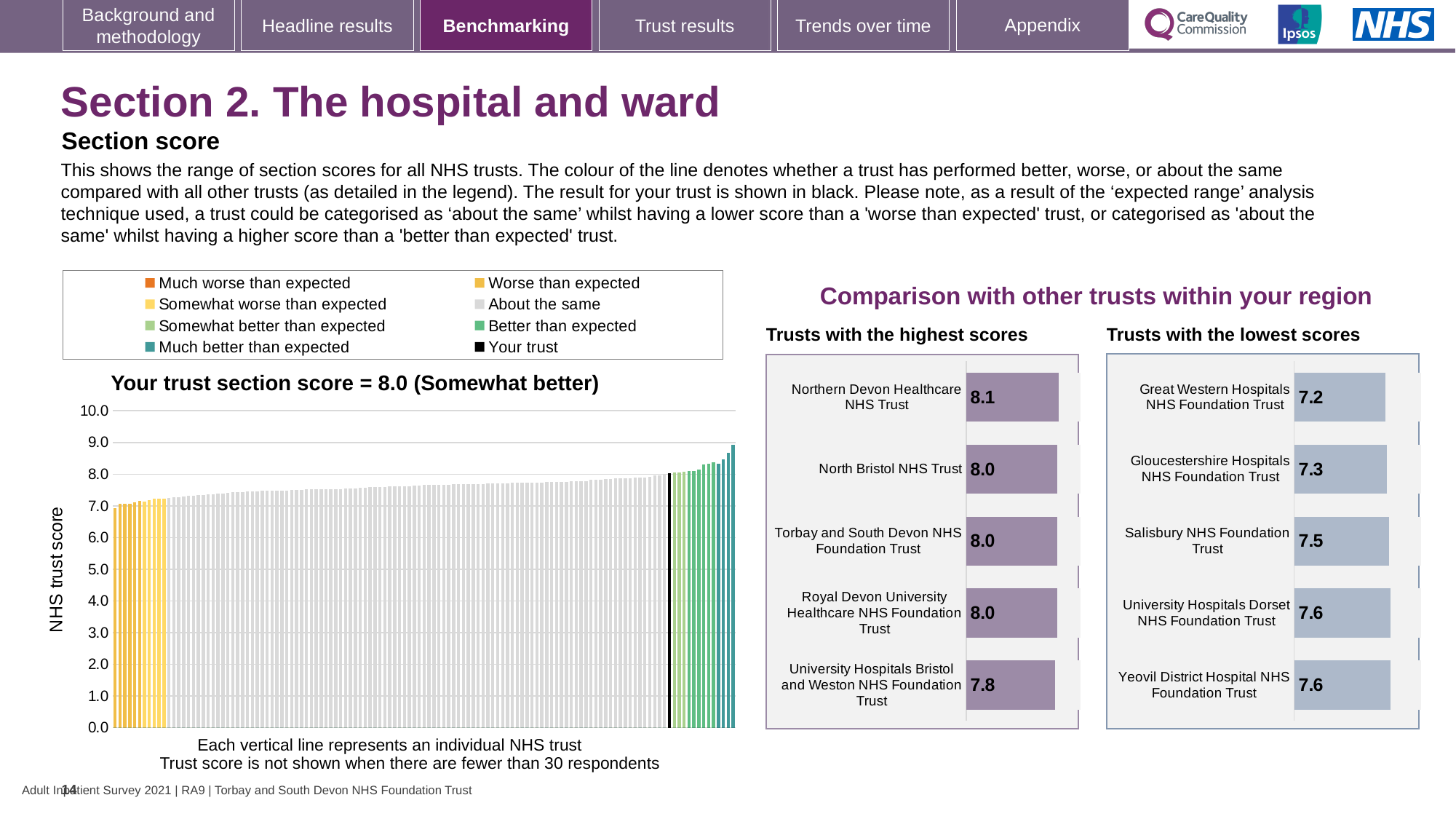
In the 'Trusts with the highest scores' chart, what is the score for Northern Devon Healthcare NHS Trust? 8.1 In the main chart on the left, what is your trust's section score? 8.0 In the 'Trusts with the lowest scores' chart, which has the larger score: Gloucestershire Hospitals NHS Foundation Trust or Salisbury NHS Foundation Trust? Salisbury NHS Foundation Trust How many entries does the legend of the main chart on the left list? 8 In the 'Trusts with the highest scores' chart, which trust has the highest score? Northern Devon Healthcare NHS Trust In the 'Trusts with the highest scores' chart, what is the score for University Hospitals Bristol and Weston NHS Foundation Trust? 7.8 In the main chart on the left, is the value for your trust (the black bar) greater or less than 7.0? greater In the 'Trusts with the highest scores' chart, what is the difference between the scores of Northern Devon Healthcare NHS Trust and University Hospitals Bristol and Weston NHS Foundation Trust? 0.3 In the 'Trusts with the lowest scores' chart, what is the difference between the scores of Salisbury NHS Foundation Trust and Great Western Hospitals NHS Foundation Trust? 0.3 In the 'Trusts with the lowest scores' chart, which trust has the lowest score? Great Western Hospitals NHS Foundation Trust In the 'Trusts with the lowest scores' chart, what is the score for Great Western Hospitals NHS Foundation Trust? 7.2 How many trusts are shown in the 'Trusts with the lowest scores' chart? 5